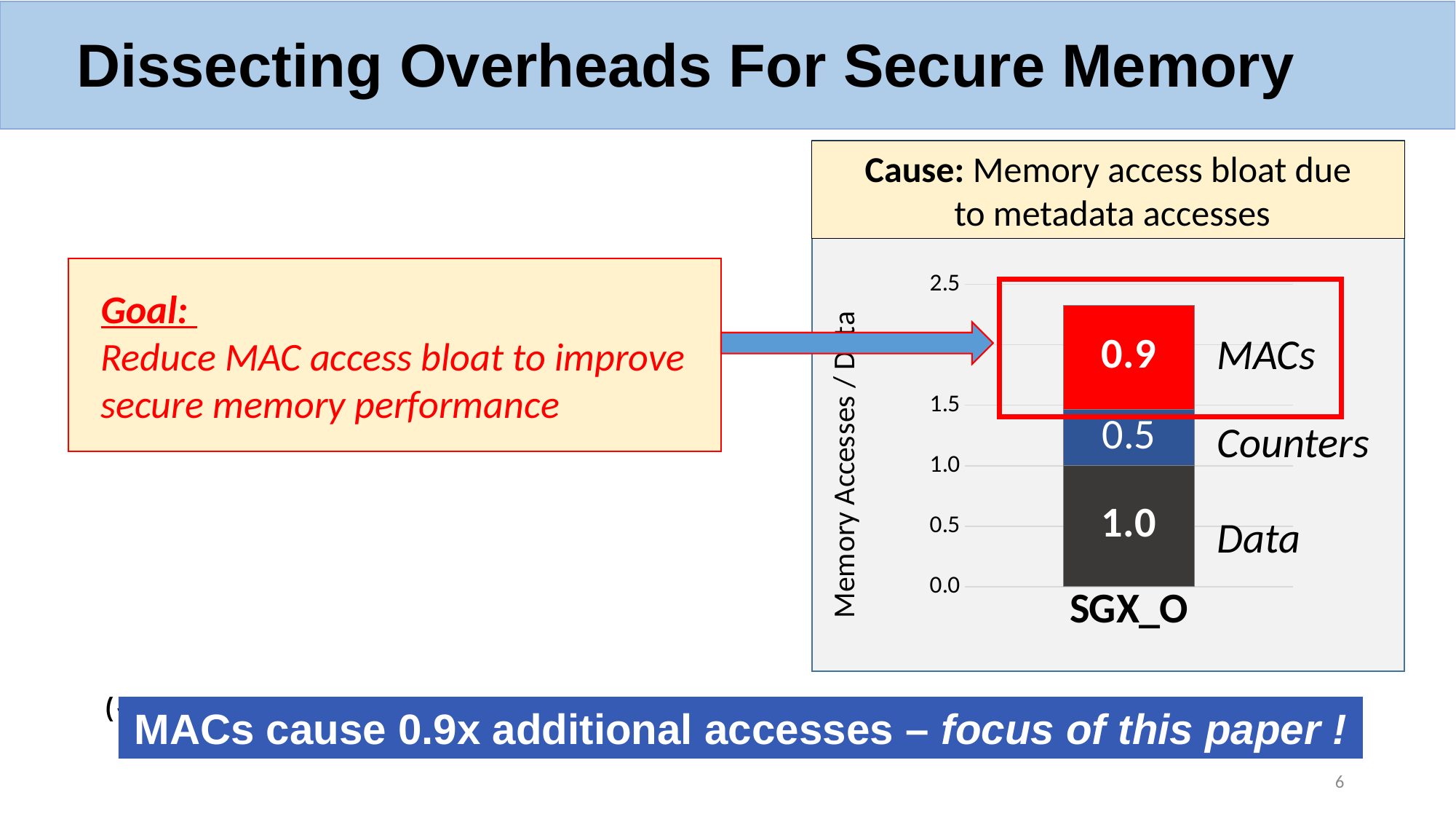
How many segments (series) make up the SGX_O bar? 3 Which is larger for SGX_O, the MACs segment or the Counters segment? MACs How many categories are shown on the x axis of the chart? 1 What is the total height of the SGX_O stacked bar? 2.4 What is the difference between the MACs and Counters values for SGX_O? 0.4 What is the value of the Counters segment for SGX_O? 0.5 Which segment of the SGX_O bar has the largest value? Data What type of chart is shown on the slide? stacked bar chart Which segment of the SGX_O bar has the smallest value? Counters What is the value of the MACs segment for SGX_O? 0.9 What is the value of the Data segment for SGX_O? 1.0 What colour is the MACs segment of the bar? red